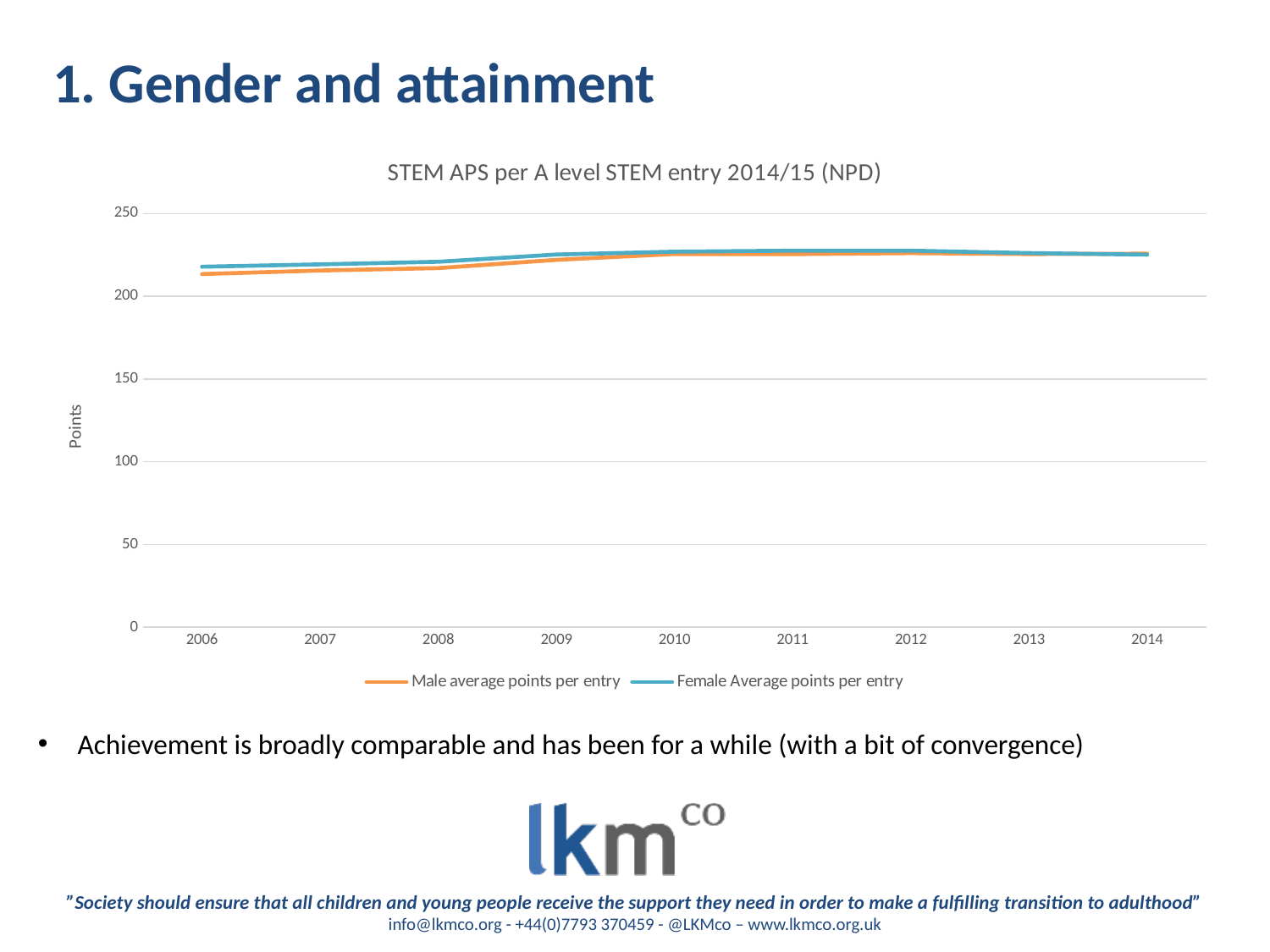
In 2008, which series has the higher value: Male average points per entry or Female Average points per entry? Female Average points per entry Is the value for Female Average points per entry in 2014 greater or less than 250? less Is the value for Male average points per entry in 2006 greater or less than 200? greater How many series does the legend list? 2 In 2006, which series has the higher value: Male average points per entry or Female Average points per entry? Female Average points per entry What is the title of the chart? STEM APS per A level STEM entry 2014/15 (NPD) What kind of chart is shown on the slide? line chart Is the value for Male average points per entry in 2010 greater or less than 200? greater What is the label on the vertical axis? Points Which year is the first on the x axis? 2006 How many years are plotted along the x axis? 9 Does the Male average points per entry line rise or fall between 2006 and 2010? rise